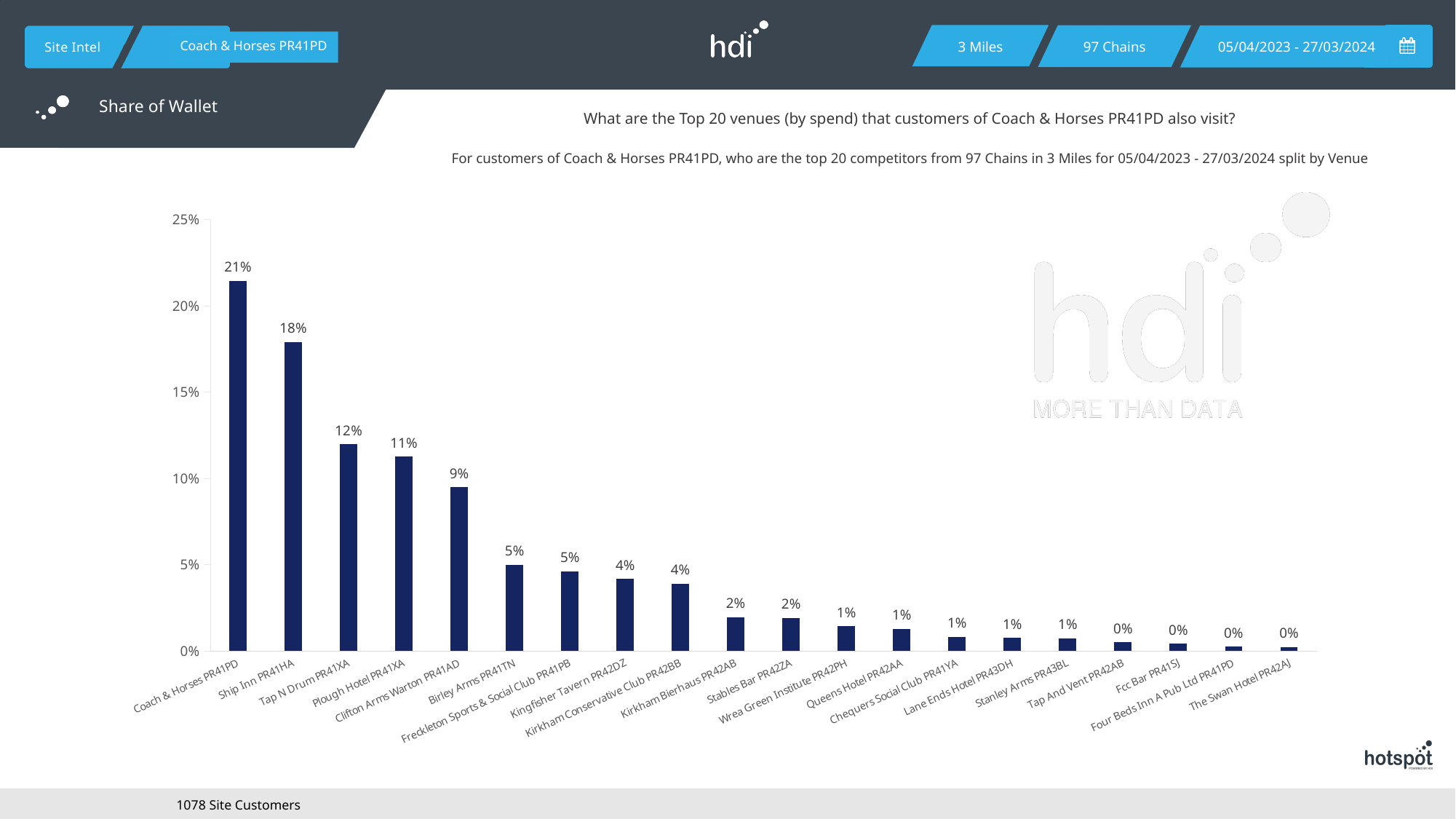
Which venue has the highest share of wallet on the chart? Coach & Horses PR41PD Do the values rise or fall moving from left to right along the x axis? fall How many venues are plotted on the chart? 20 What is the value shown for Ship Inn PR41HA? 18% What is the value shown for Kirkham Bierhaus PR42AB? 2% What kind of chart is shown on the slide? bar chart What is the title question shown above the chart? What are the Top 20 venues (by spend) that customers of Coach & Horses PR41PD also visit? Which is larger, the value for Ship Inn PR41HA or the value for Tap N Drum PR41XA? Ship Inn PR41HA What is the value shown for Tap N Drum PR41XA? 12% Is the value for Plough Hotel PR41XA greater or less than 10%? greater What is the difference between the values for Coach & Horses PR41PD and Ship Inn PR41HA? 3% What is the value shown for Clifton Arms Warton PR41AD? 9%